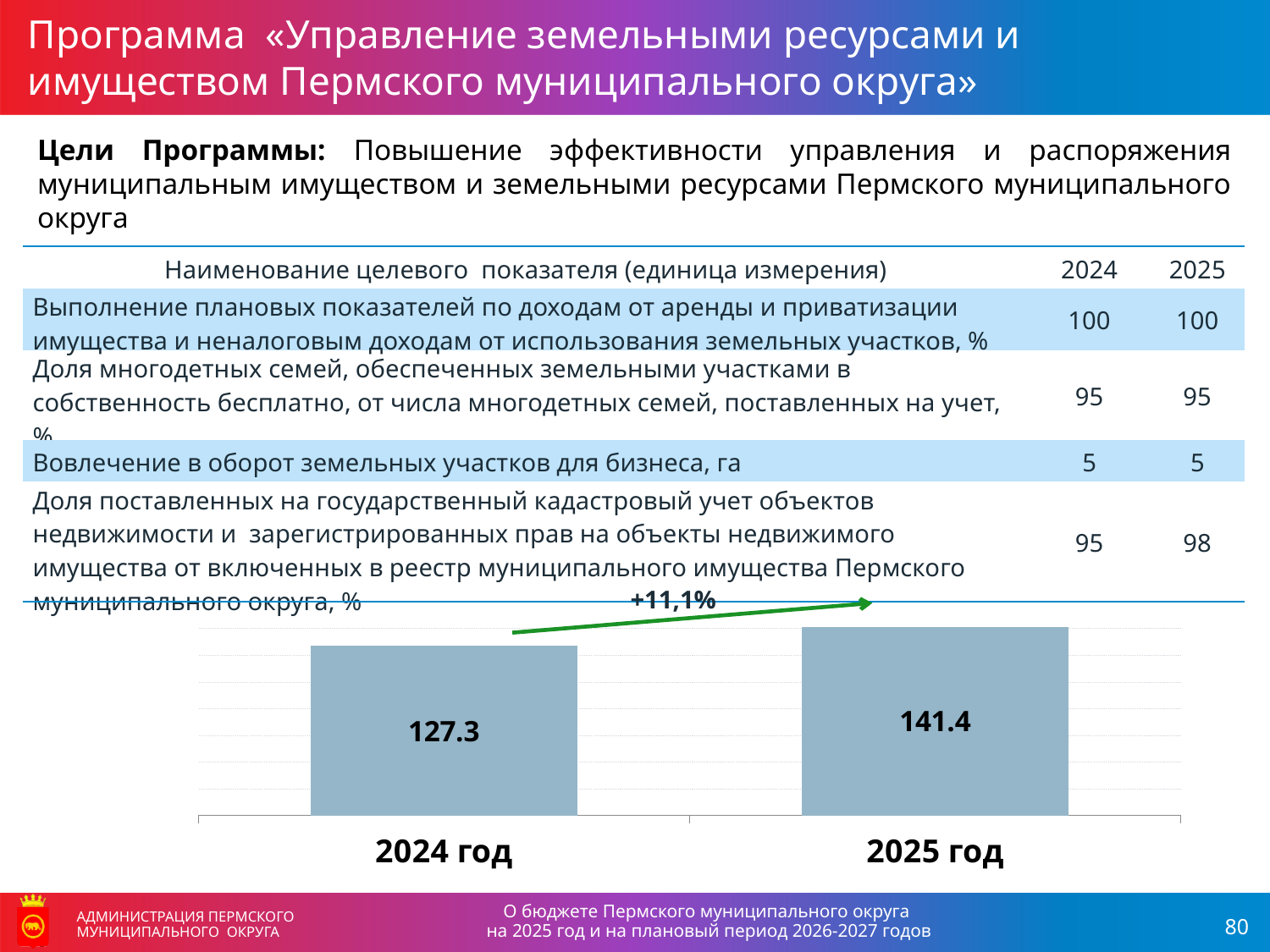
Which year has the lowest bar in the chart? 2024 год What is the value of the bar for 2024 год? 127.3 What are the two category labels on the x axis of the chart? 2024 год and 2025 год What percentage change is written above the arrow between the two bars? +11,1% What is the value of the bar for 2025 год? 141.4 What kind of chart is shown at the bottom of the slide? Bar chart What is the difference between the values for 2025 год and 2024 год? 14.1 Which year has the highest bar in the chart? 2025 год Do the values rise or fall from 2024 год to 2025 год? Rise How many bars are shown in the chart? 2 Which is larger, the value for 2024 год or the value for 2025 год? 2025 год